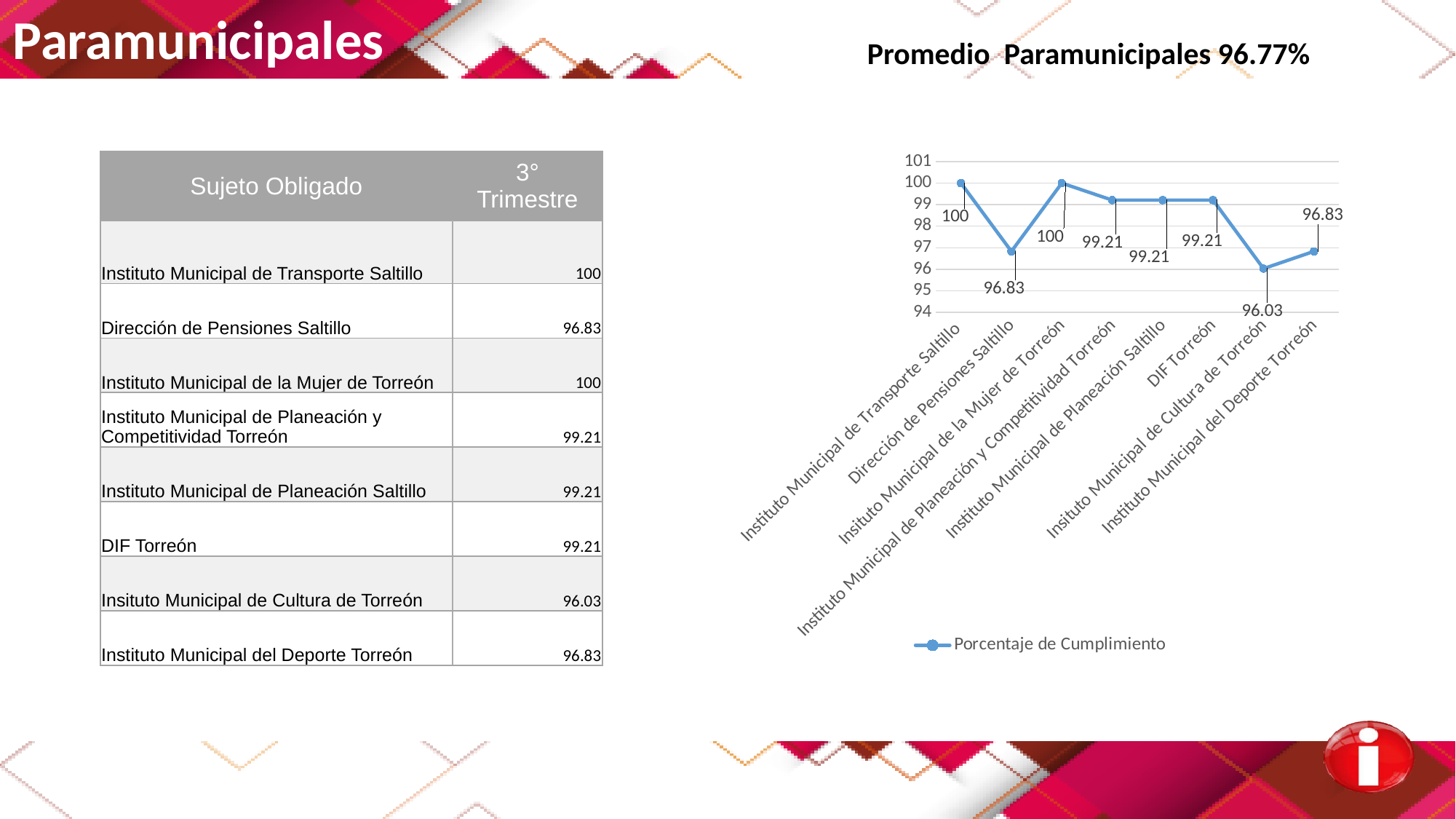
What is the difference between the values for DIF Torreón and Instituto Municipal del Deporte Torreón? 2.38 How many categories are plotted in the chart? 8 What kind of chart is shown on the slide? line chart What is the value for Insituto Municipal de Cultura de Torreón in the chart? 96.03 What is the difference between the values for Instituto Municipal de Transporte Saltillo and Insituto Municipal de Cultura de Torreón? 3.97 What is the name of the series shown in the chart legend? Porcentaje de Cumplimiento Which category has the lowest value in the chart? Insituto Municipal de Cultura de Torreón Which is larger, the value for Instituto Municipal de Planeación Saltillo or the value for Instituto Municipal del Deporte Torreón? Instituto Municipal de Planeación Saltillo What is the value for Dirección de Pensiones Saltillo in the chart? 96.83 Is the value for Dirección de Pensiones Saltillo greater or less than 98? less What is the value for DIF Torreón in the chart? 99.21 How many series does the chart legend list? 1